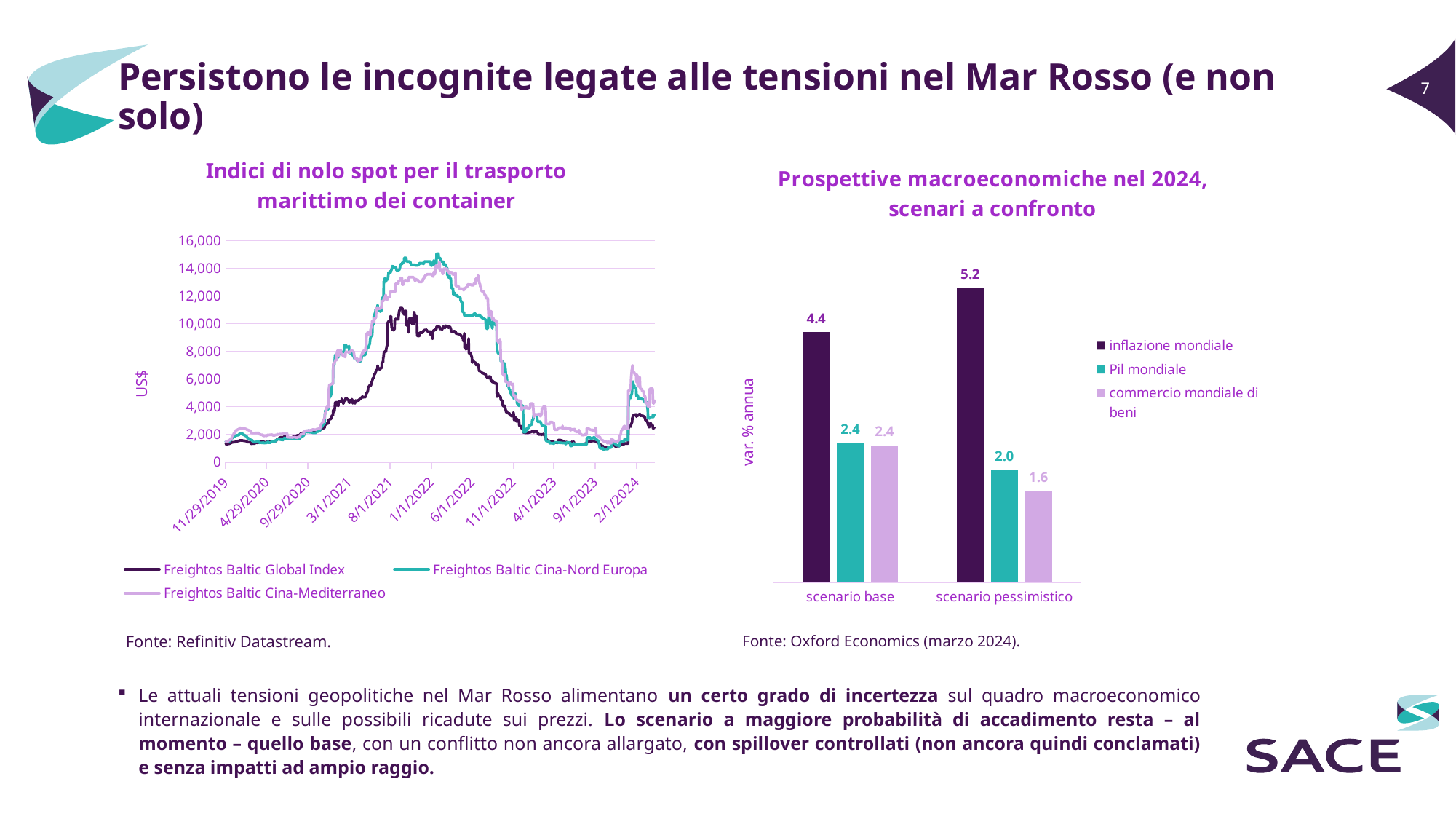
What unit is shown on the y axis of the chart 'Indici di nolo spot per il trasporto marittimo dei container'? US$ In the chart 'Prospettive macroeconomiche nel 2024, scenari a confronto', what is the value for commercio mondiale di beni in the scenario pessimistico? 1.6 In the chart 'Prospettive macroeconomiche nel 2024, scenari a confronto', what is the value for inflazione mondiale in the scenario base? 4.4 In the chart 'Prospettive macroeconomiche nel 2024, scenari a confronto', which series has the highest value in the scenario pessimistico? inflazione mondiale In the chart 'Prospettive macroeconomiche nel 2024, scenari a confronto', what is the value for Pil mondiale in the scenario pessimistico? 2.0 In the chart 'Indici di nolo spot per il trasporto marittimo dei container', is the peak value of the Freightos Baltic Global Index greater or less than 12,000? less How many series does the legend of the chart 'Prospettive macroeconomiche nel 2024, scenari a confronto' list? 3 How many series does the legend of the chart 'Indici di nolo spot per il trasporto marittimo dei container' list? 3 In the chart 'Prospettive macroeconomiche nel 2024, scenari a confronto', what is the difference between inflazione mondiale in the scenario pessimistico and in the scenario base? 0.8 In the chart 'Prospettive macroeconomiche nel 2024, scenari a confronto', is Pil mondiale larger in the scenario base or in the scenario pessimistico? scenario base What kind of chart is 'Indici di nolo spot per il trasporto marittimo dei container'? line chart What kind of chart is 'Prospettive macroeconomiche nel 2024, scenari a confronto'? bar chart